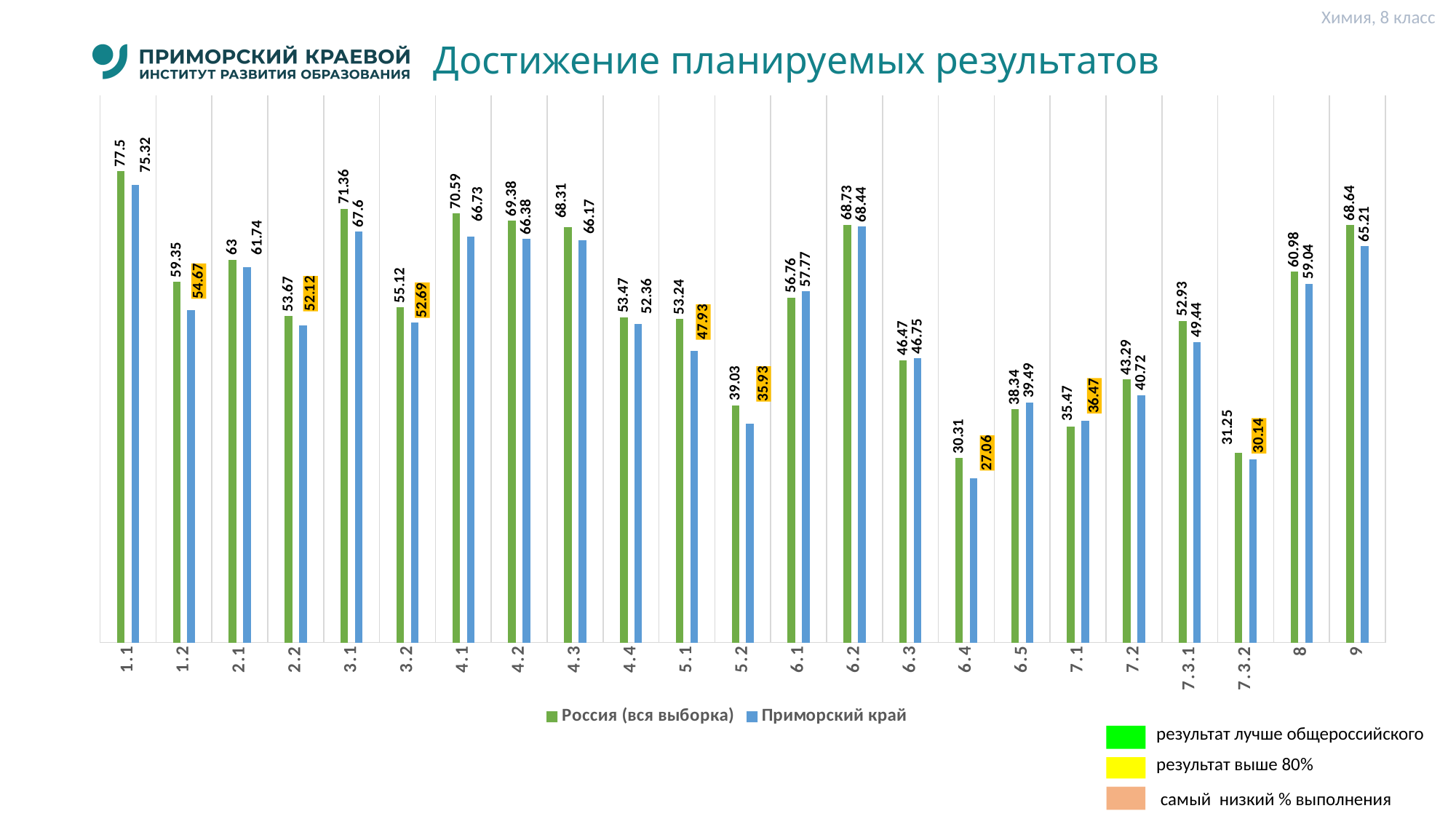
What is the value for Приморский край for category 6.4? 27.06 What kind of chart is shown on the slide? bar chart Which category has the highest value for Приморский край? 1.1 What is the value for Россия (вся выборка) for category 7.3.2? 31.25 What is the value for Россия (вся выборка) for category 3.1? 71.36 How many categories are shown on the x axis? 23 What is the difference between the Россия (вся выборка) and Приморский край values for category 5.1? 5.31 What is the title of the chart on the slide? Достижение планируемых результатов Which category has the lowest value for Россия (вся выборка)? 6.4 How many series does the chart legend list? 2 For category 6.1, which series has the larger value: Россия (вся выборка) or Приморский край? Приморский край What is the value for Приморский край for category 1.2? 54.67